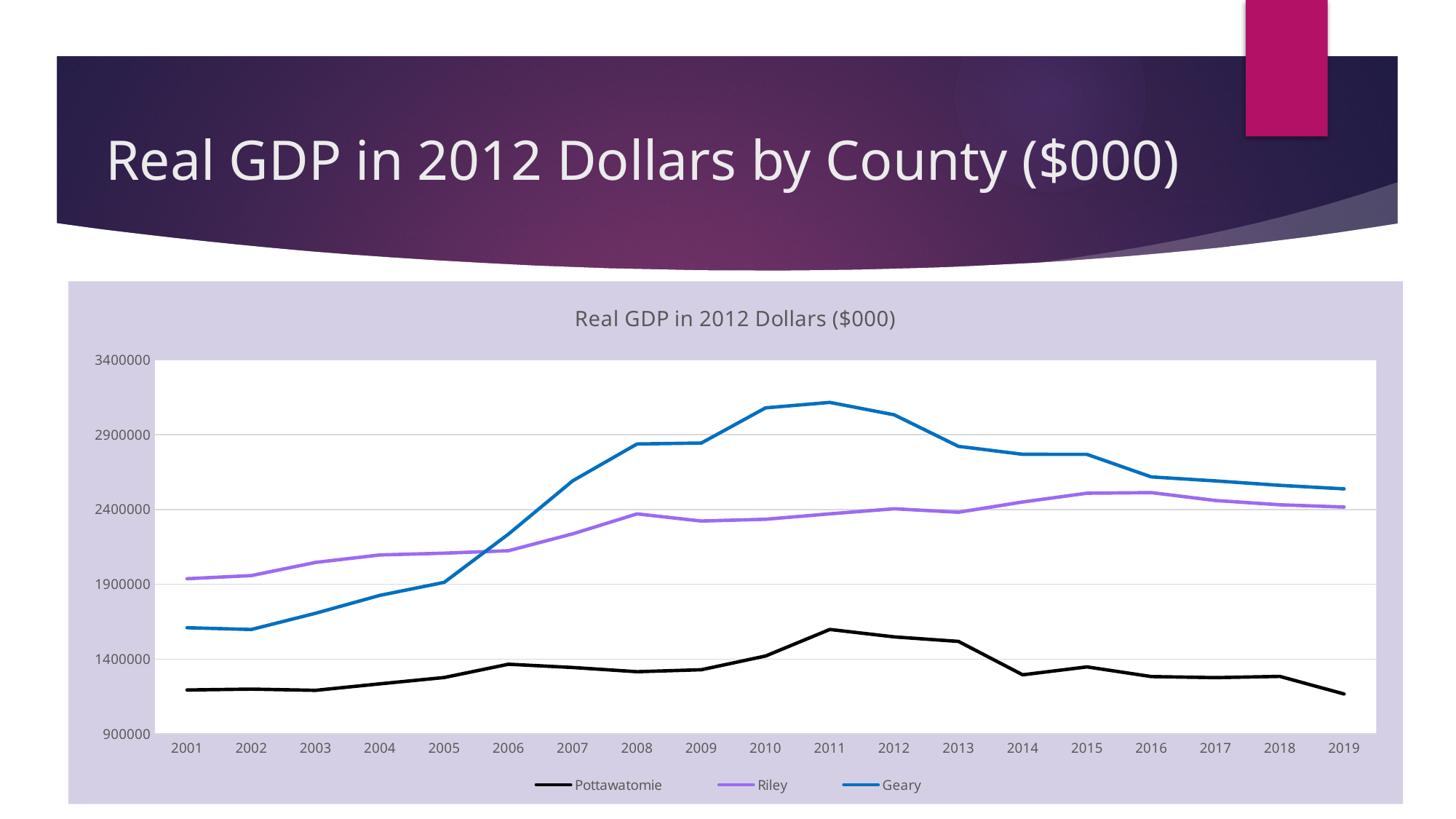
What is the title of the chart? Real GDP in 2012 Dollars ($000) How many years are plotted along the x axis? 19 Is the value for Geary in 2011 greater or less than 2900000? greater In which year does the Geary line reach its highest value? 2011 What kind of chart is shown on the slide? line chart Which county has the lowest Real GDP in 2011? Pottawatomie Does the Geary line rise or fall from 2011 to 2019? fall Which is larger in 2005, the value for Riley or the value for Geary? Riley Is the value for Pottawatomie in 2019 greater or less than 1400000? less How many series does the legend list? 3 Which county has the highest Real GDP in 2019? Geary In which year does the Pottawatomie line reach its lowest value? 2019